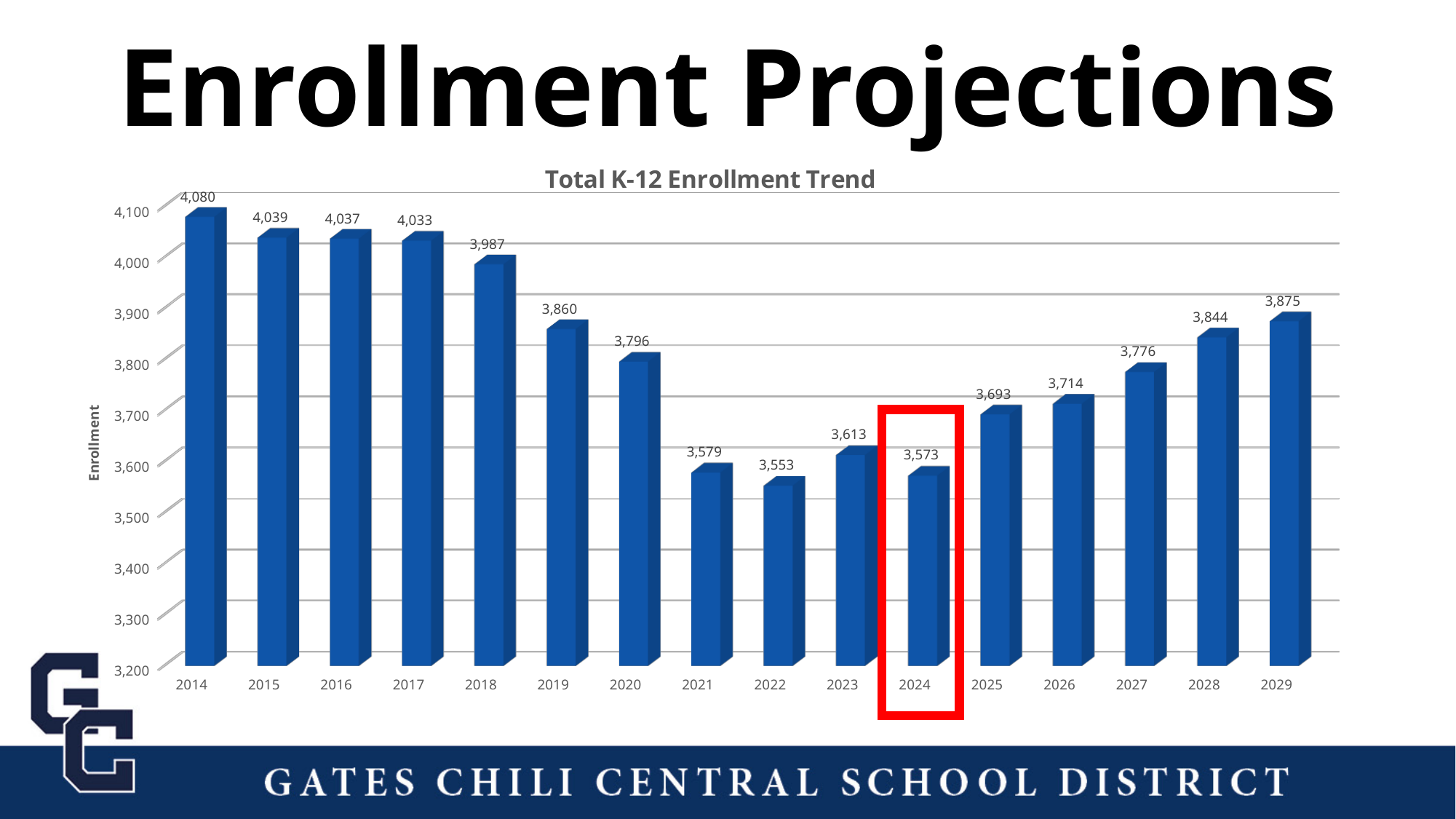
What is the difference in enrollment between 2014 and 2022? 527 Which year has higher enrollment, 2019 or 2028? 2019 Which year has the lowest enrollment? 2022 What kind of chart is this? Bar chart What is the title of the chart? Total K-12 Enrollment Trend What is the enrollment value for 2029? 3,875 How many years are shown on the x axis? 16 Which year has the highest enrollment? 2014 Is the value for 2020 greater or less than 3,800? less What is the enrollment value for 2014? 4,080 What is the enrollment value for 2024? 3,573 Do the values rise or fall from 2014 to 2022? Fall